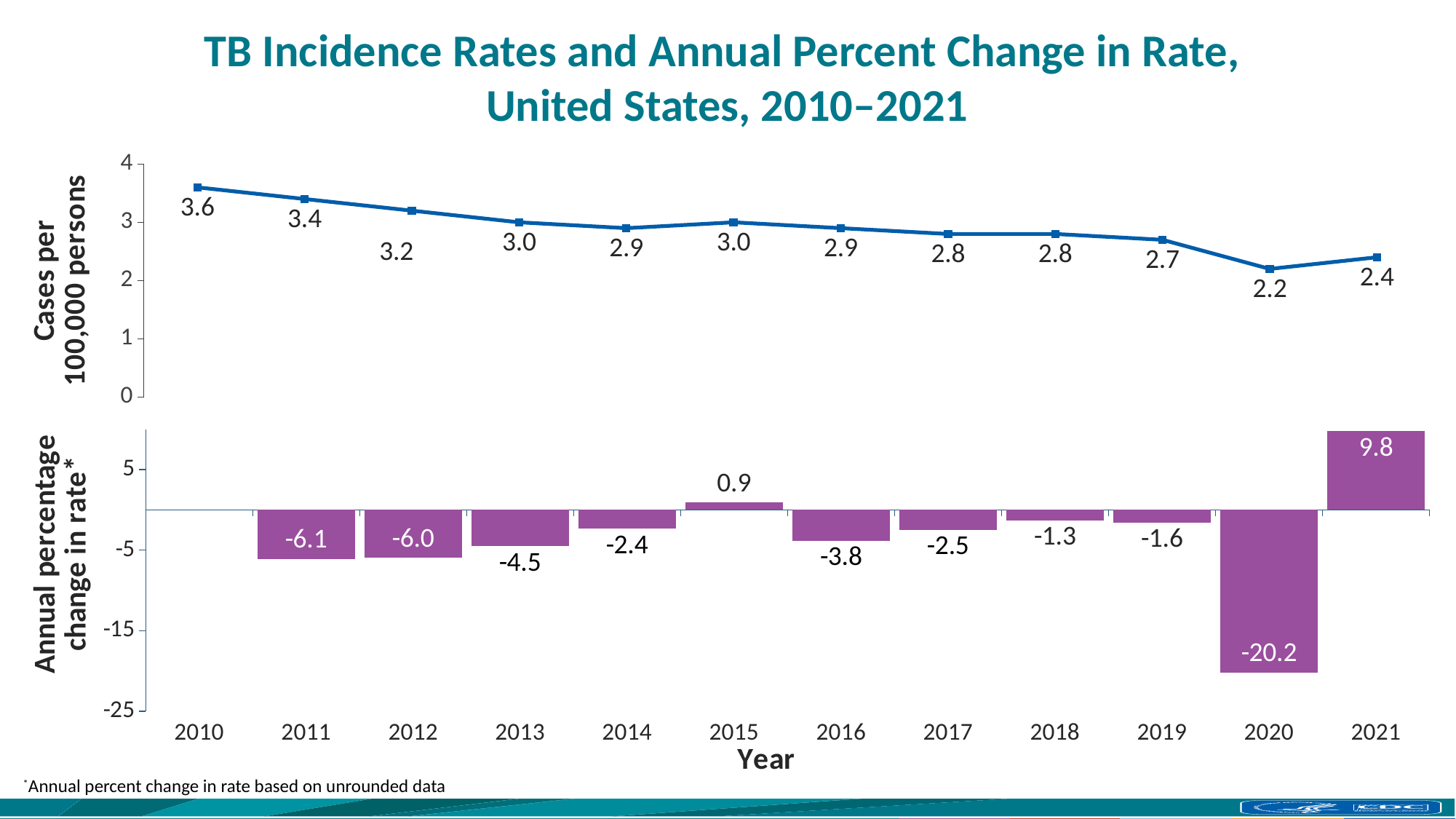
In the top chart (cases per 100,000 persons), how many data points are plotted? 12 What kind of chart is the top chart (cases per 100,000 persons)? Line chart In the bottom chart (annual percentage change in rate), which year had the largest positive percent change? 2021 In the bottom chart (annual percentage change in rate), what was the annual percent change in 2020? -20.2 In the top chart (cases per 100,000 persons), what was the TB incidence rate in 2020? 2.2 In the top chart (cases per 100,000 persons), what is the overall trend of the incidence rate from 2010 to 2021? Falling In the top chart (cases per 100,000 persons), what is the difference between the 2010 rate and the 2021 rate? 1.2 In the bottom chart (annual percentage change in rate), is the value for 2011 larger or smaller than the value for 2018? Smaller In the top chart (cases per 100,000 persons), what was the TB incidence rate in 2010? 3.6 In the top chart (cases per 100,000 persons), which year had the highest incidence rate? 2010 What kind of chart is the bottom chart (annual percentage change in rate)? Bar chart In the top chart (cases per 100,000 persons), which year had the lowest incidence rate? 2020